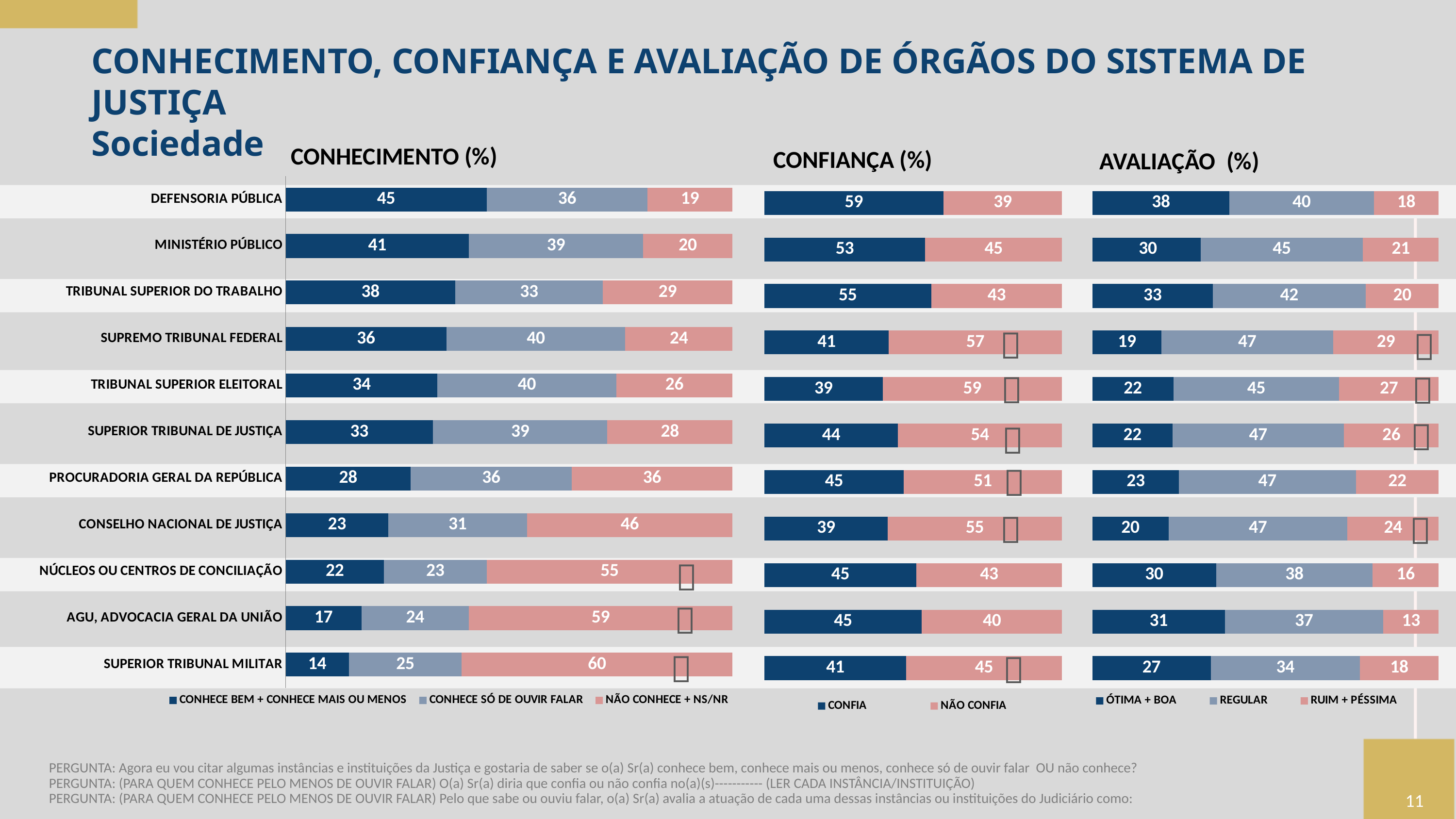
In the CONFIANÇA (%) chart, what is the CONFIA value for SUPREMO TRIBUNAL FEDERAL? 41 In the CONHECIMENTO (%) chart, what is the total of the three segments for PROCURADORIA GERAL DA REPÚBLICA? 100 How many institutions are listed in the CONHECIMENTO (%) chart? 11 How many series does the legend of the CONHECIMENTO (%) chart list? 3 In the AVALIAÇÃO (%) chart, which institution has the highest RUIM + PÉSSIMA value? SUPREMO TRIBUNAL FEDERAL In the CONFIANÇA (%) chart, how much larger is NÃO CONFIA than CONFIA for TRIBUNAL SUPERIOR ELEITORAL? 20 What type of chart is the CONFIANÇA (%) chart? Stacked bar chart In the CONHECIMENTO (%) chart, which institution has the lowest CONHECE BEM + CONHECE MAIS OU MENOS value? SUPERIOR TRIBUNAL MILITAR In the AVALIAÇÃO (%) chart, what is the REGULAR value for CONSELHO NACIONAL DE JUSTIÇA? 47 In the AVALIAÇÃO (%) chart, which has the larger ÓTIMA + BOA value: DEFENSORIA PÚBLICA or SUPREMO TRIBUNAL FEDERAL? DEFENSORIA PÚBLICA In the CONFIANÇA (%) chart, which institution has the highest CONFIA value? DEFENSORIA PÚBLICA In the CONHECIMENTO (%) chart, what is the value of CONHECE BEM + CONHECE MAIS OU MENOS for DEFENSORIA PÚBLICA? 45